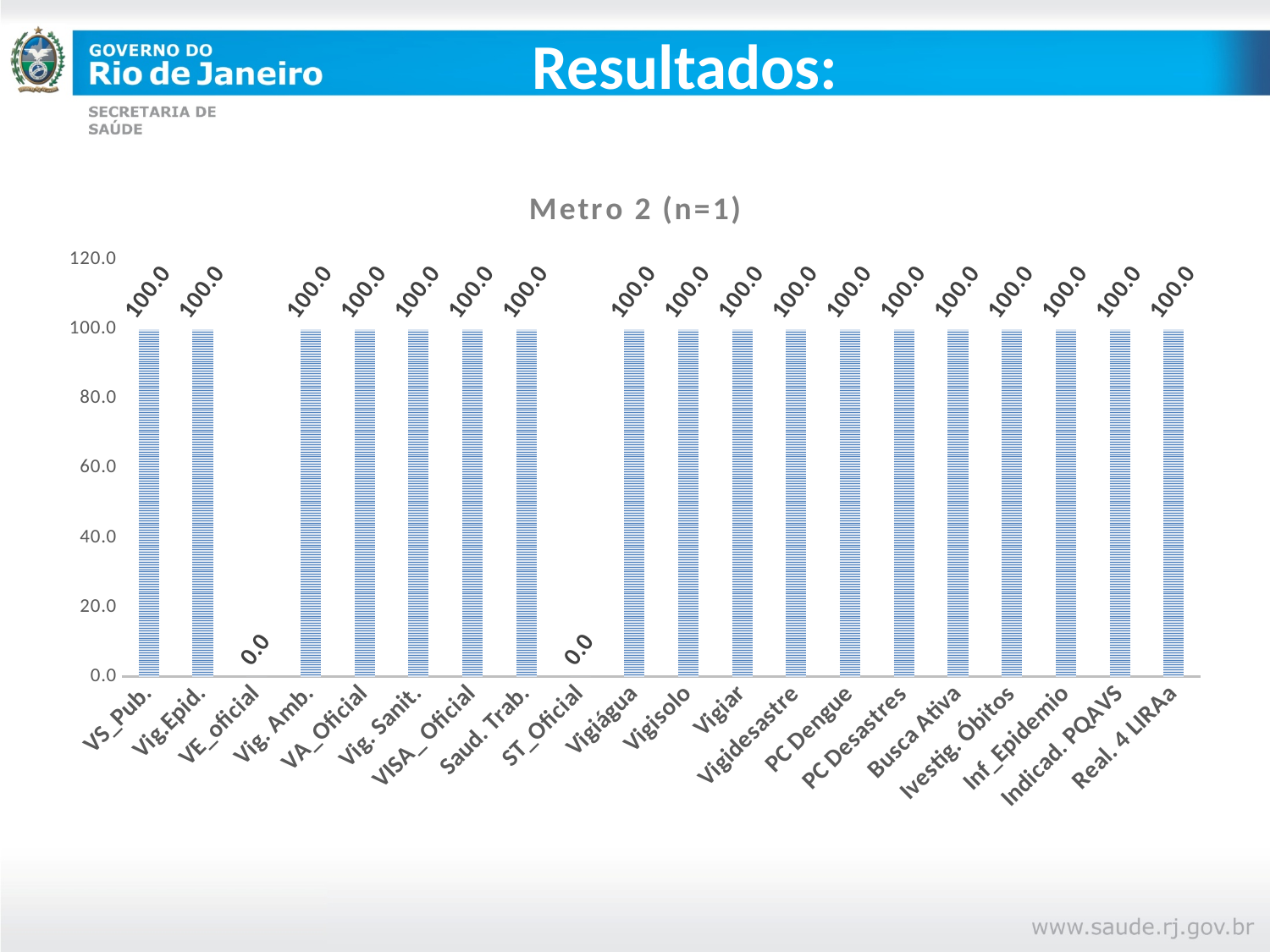
What is the value for ST_Oficial? 0.0 What kind of chart is shown on the slide? Bar chart Which two categories have the lowest value? VE_oficial and ST_Oficial How many categories are shown on the x axis? 20 Is the value for PC Dengue greater or less than 80.0? greater Which is larger, the value for Saud. Trab. or the value for ST_Oficial? Saud. Trab. What is the difference between the values for Vig.Epid. and VE_oficial? 100.0 What is the title of the chart? Metro 2 (n=1) What is the value for VE_oficial? 0.0 What is the value for VS_Pub.? 100.0 How many categories have a value of 0.0? 2 What is the value for Real. 4 LIRAa? 100.0